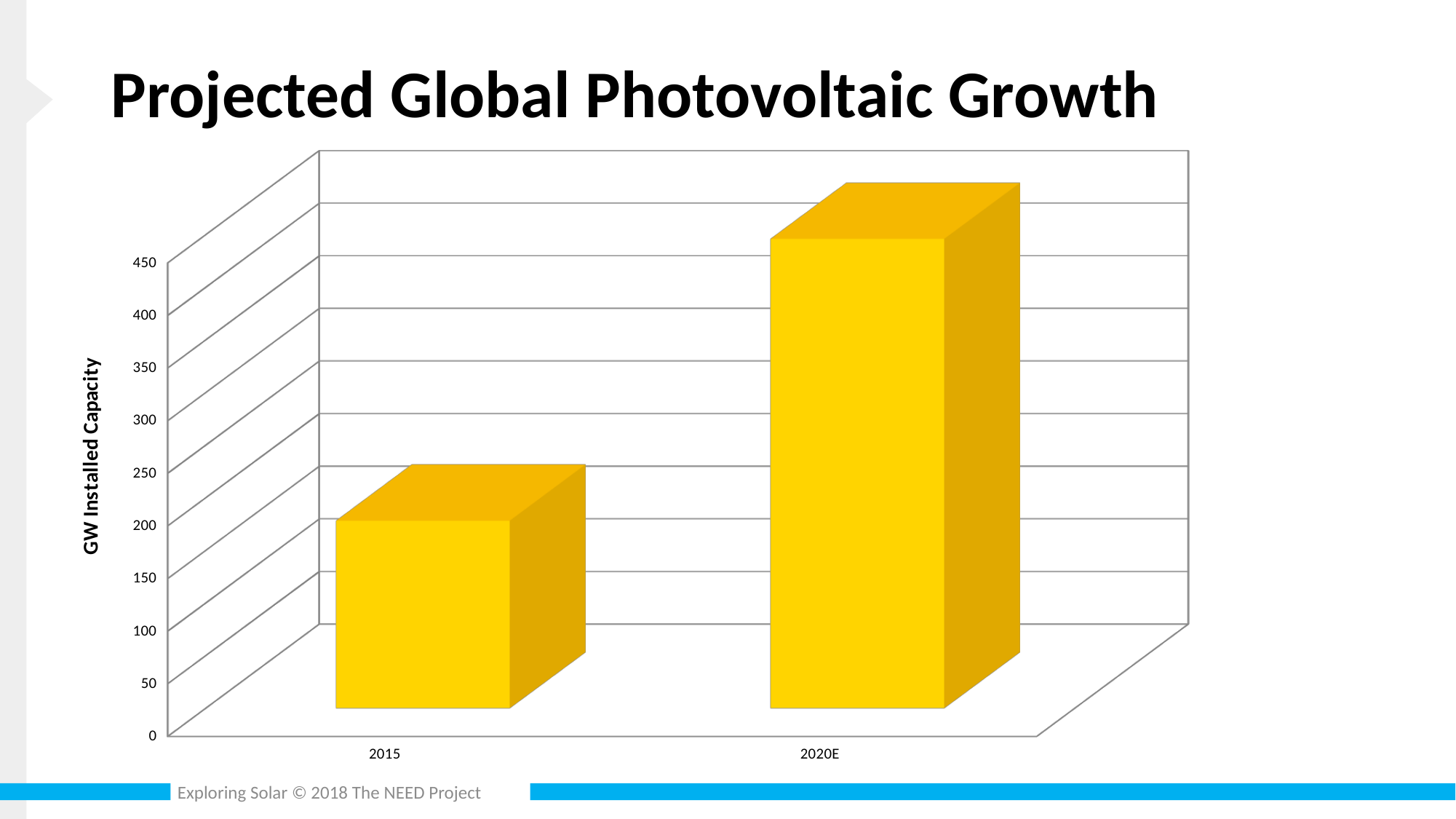
Is the value for 2015 greater or less than 100? greater Which is larger, the value for 2015 or the value for 2020E? 2020E Which category has the lowest GW installed capacity? 2015 Is the value for 2020E greater or less than 300? greater What is the title of the chart? Projected Global Photovoltaic Growth What kind of chart is shown on the slide? bar chart Is the value for 2015 greater or less than 250? less How many bars (categories) are plotted in the chart? 2 What is the label on the vertical axis? GW Installed Capacity Do the values rise or fall from 2015 to 2020E? rise Which category has the highest GW installed capacity? 2020E